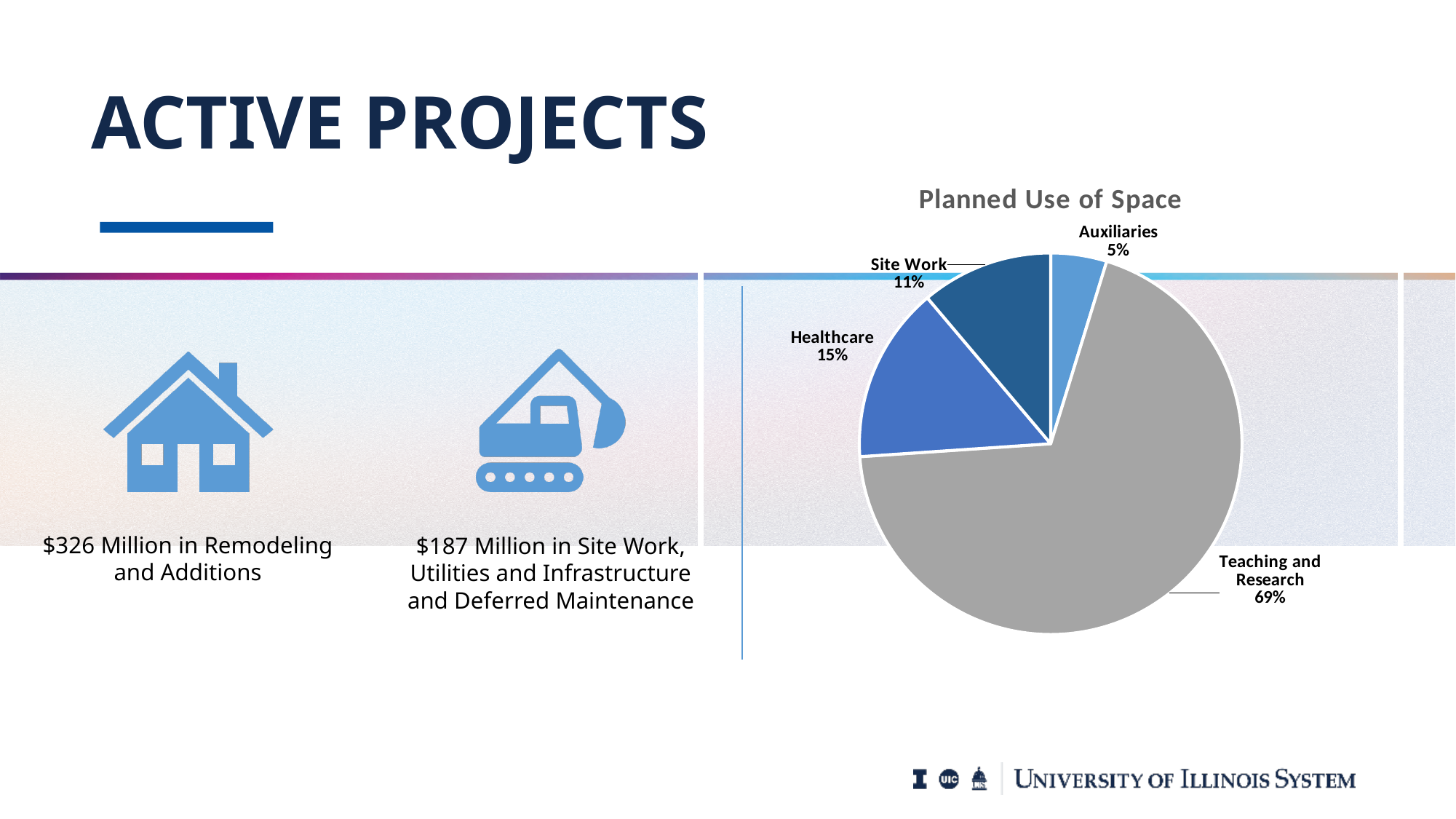
What colour is the Teaching and Research slice? Gray How many categories are shown in the pie chart? 4 What share of the pie does Teaching and Research represent? 69% What is the title of the chart? Planned Use of Space What type of chart is shown on the slide? Pie chart What share of the pie does Auxiliaries represent? 5% Which category has the largest slice of the pie? Teaching and Research Which category has the smallest slice of the pie? Auxiliaries What share of the pie does Healthcare represent? 15% Which is larger, the Healthcare slice or the Auxiliaries slice? Healthcare What is the difference in percentage points between Healthcare and Site Work? 4